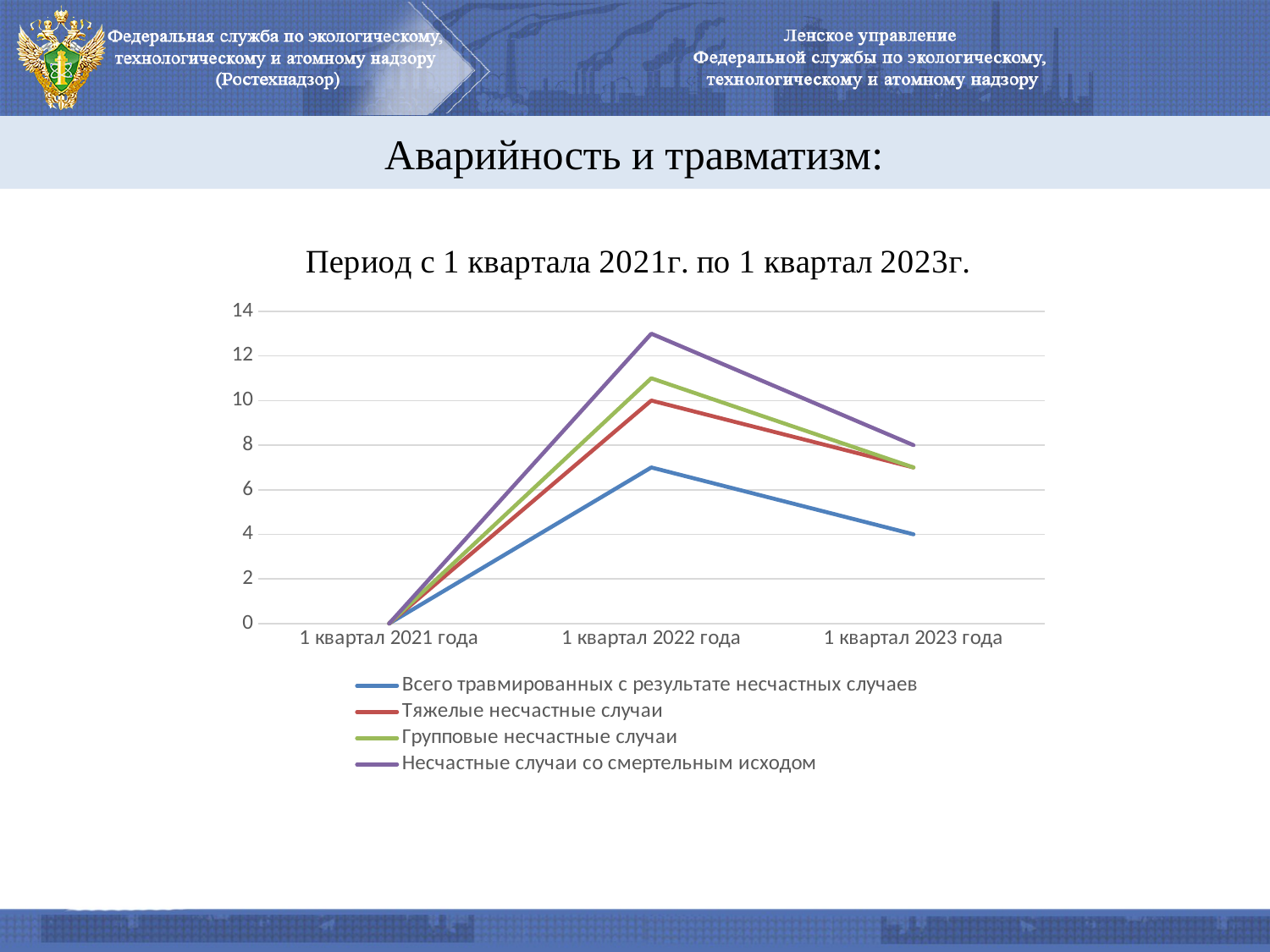
What is the value for 'Групповые несчастные случаи' in 1 квартал 2021 года? 0 What is the value for 'Всего травмированных с результате несчастных случаев' in 1 квартал 2023 года? 4 Is the value for 'Всего травмированных с результате несчастных случаев' in 1 квартал 2022 года greater or less than 8? less How many series does the legend list? 4 How many points along the x axis does the chart have? 3 What kind of chart is shown on the slide? line chart